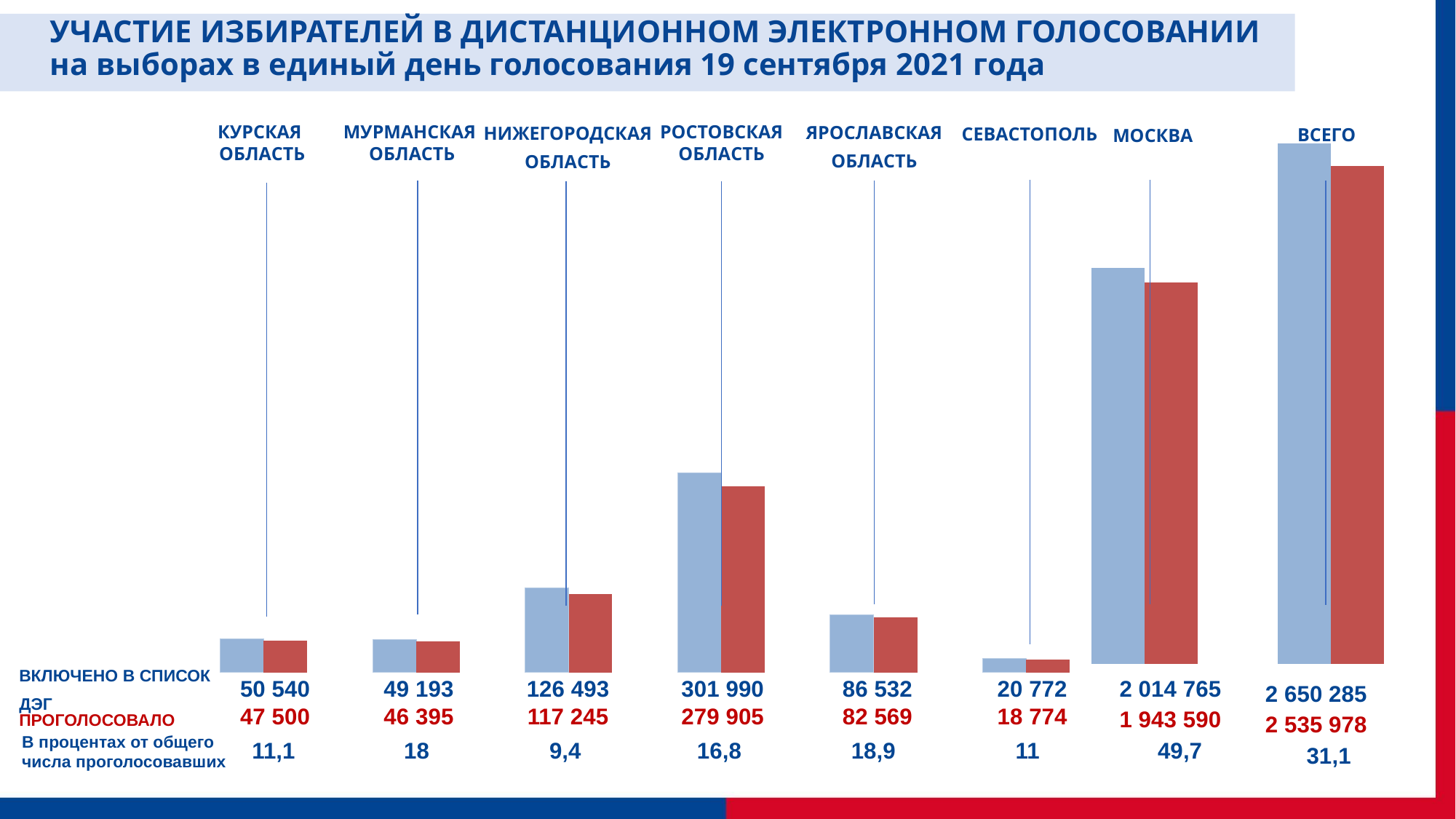
What is the difference between the number included in the list and the number who voted in Курская область? 3 040 Which region has the lowest percentage of the total number of voters? Нижегородская область How many voters were included in the DEG list (ВКЛЮЧЕНО В СПИСОК ДЭГ) in Ростовская область? 301 990 Which has more voters who voted: Курская область or Мурманская область? Курская область How many voters voted (ПРОГОЛОСОВАЛО) in Москва? 1 943 590 How many categories (regions plus the total) are shown on the chart? 8 Excluding the ВСЕГО total, which region has the highest number of voters included in the DEG list? Москва What is the total (ВСЕГО) number of voters who voted (ПРОГОЛОСОВАЛО)? 2 535 978 What is the difference between the number included in the list and the number who voted in Москва? 71 175 Which region has the lowest number of voters who voted (ПРОГОЛОСОВАЛО)? Севастополь What is the percentage of the total number of voters (В процентах от общего числа проголосовавших) for Ярославская область? 18,9 What kind of chart is shown on the slide? Bar chart